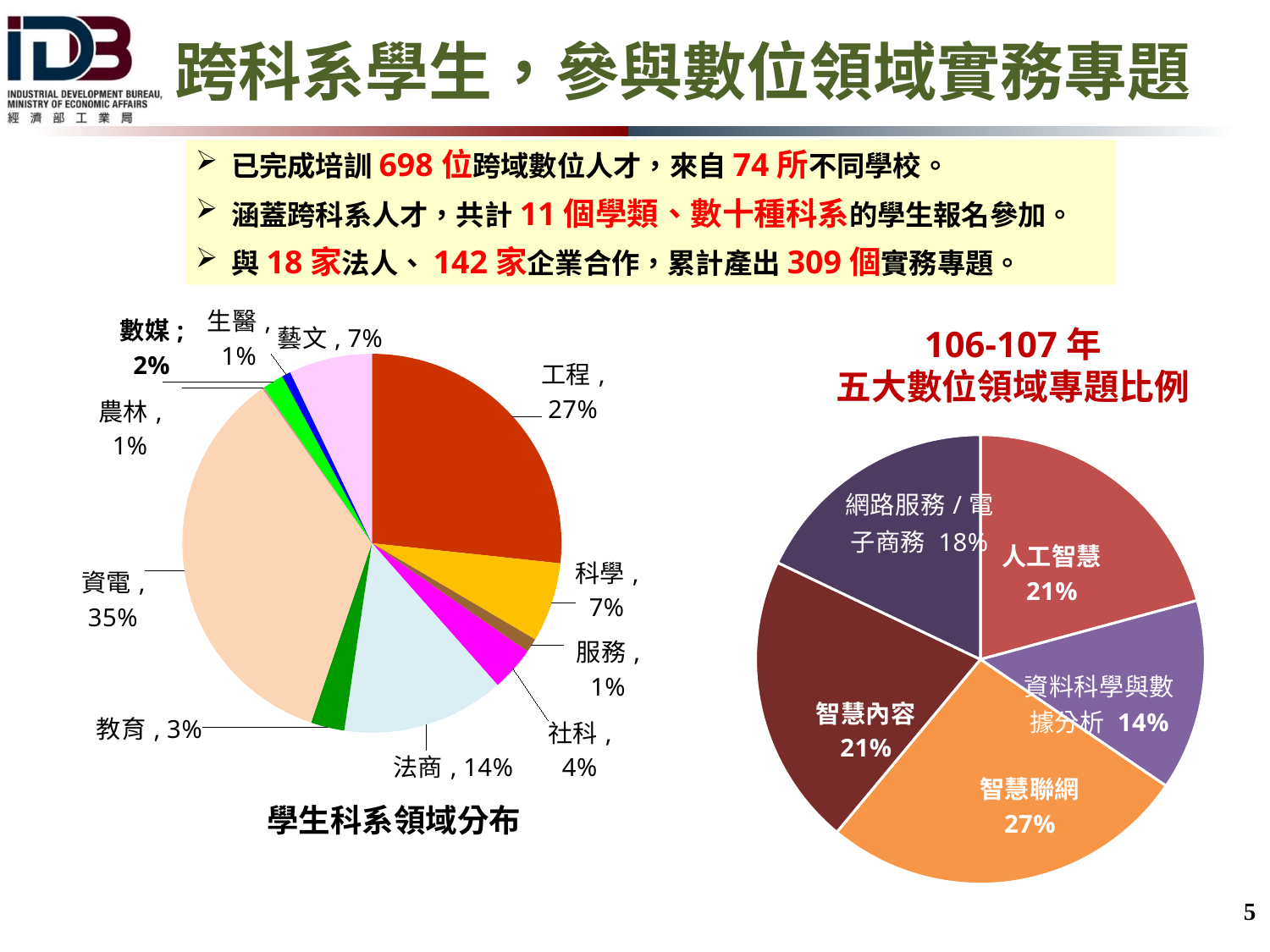
In the 106-107 年 五大數位領域專題比例 pie chart, how many categories are shown? 5 In the 學生科系領域分布 pie chart, which category has the largest share? 資電 In the 106-107 年 五大數位領域專題比例 pie chart, which category has the smallest share? 資料科學與數據分析 What is the title of the pie chart on the left of the slide? 學生科系領域分布 In the 106-107 年 五大數位領域專題比例 pie chart, what share does 智慧聯網 have? 27% In the 學生科系領域分布 pie chart, what is the difference between the shares of 工程 and 科學? 20% In the 學生科系領域分布 pie chart, how many categories are shown? 11 In the 學生科系領域分布 pie chart, which is larger, 社科 or 教育? 社科 In the 106-107 年 五大數位領域專題比例 pie chart, what is the difference between the shares of 智慧聯網 and 網路服務/電子商務? 9% In the 學生科系領域分布 pie chart, what share does 資電 have? 35% What kind of chart is the 106-107 年 五大數位領域專題比例 chart? Pie chart In the 學生科系領域分布 pie chart, what share does 法商 have? 14%